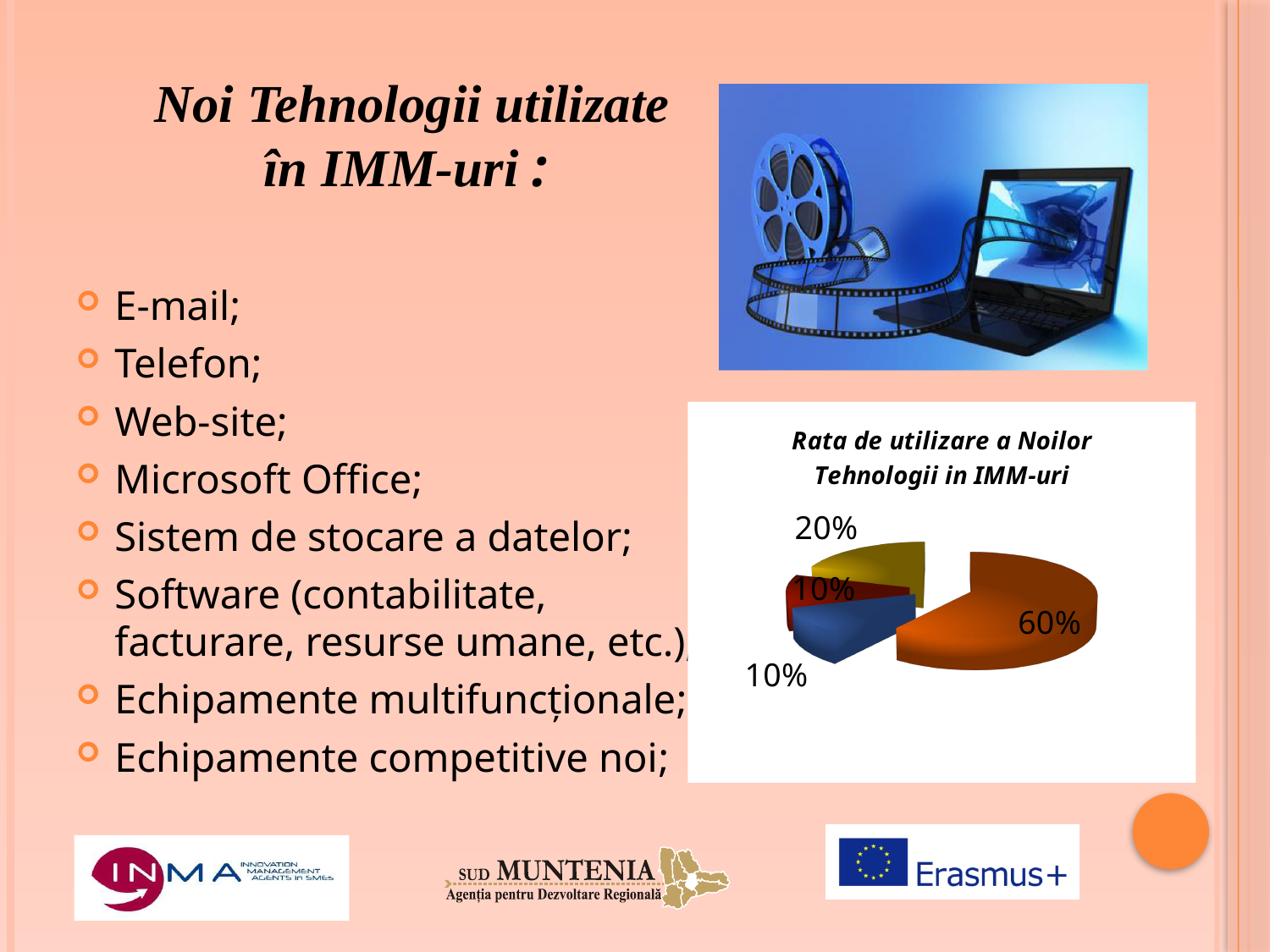
What share does the orange slice of the pie chart represent? 60% Is the share of the orange slice greater or less than 50%? greater What kind of chart is shown on the slide? pie chart Which slice is larger in the pie chart, the orange one or the yellow one? the orange one How many slices in the pie chart are labelled 10%? 2 How many slices does the pie chart have? 4 What share does the yellow slice of the pie chart represent? 20% What is the largest share shown in the pie chart? 60% What is the smallest share shown in the pie chart? 10% What is the title of the chart on the slide? Rata de utilizare a Noilor Tehnologii in IMM-uri What is the difference between the largest slice and the yellow slice in the pie chart? 40% What share does the blue slice of the pie chart represent? 10%